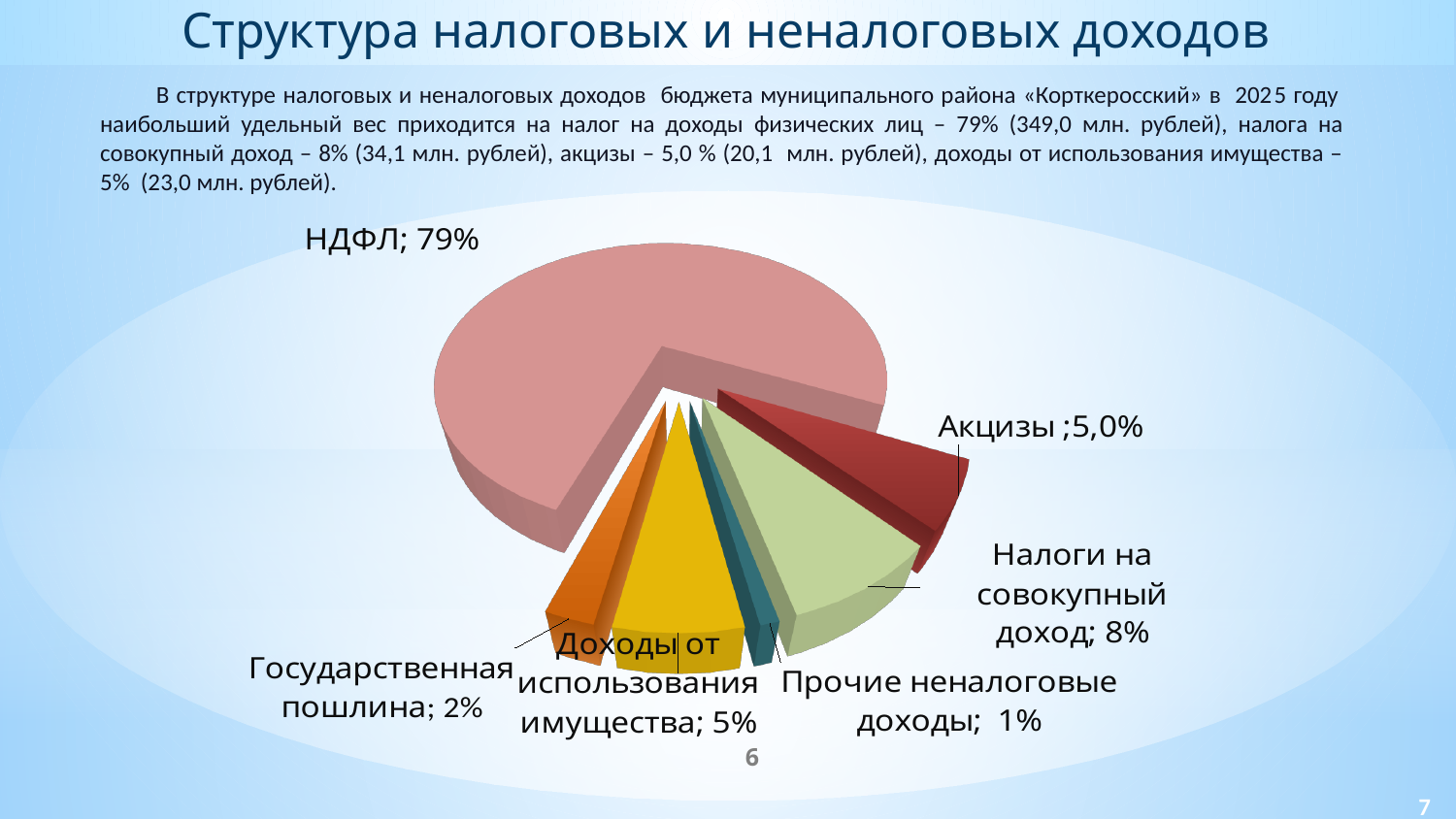
Which category has the largest slice of the pie? НДФЛ What is the value shown for Прочие неналоговые доходы? 1% What share of the pie does НДФЛ account for? 79% How many slices does the pie chart have? 6 What kind of chart is shown on the slide? Pie chart What is the value shown for Доходы от использования имущества? 5% What is the value shown for Государственная пошлина? 2% What is the value shown for Акцизы? 5,0% Which is larger, Налоги на совокупный доход or Государственная пошлина? Налоги на совокупный доход What is the value shown for Налоги на совокупный доход? 8% Which category has the smallest slice of the pie? Прочие неналоговые доходы By how many percentage points does НДФЛ exceed Налоги на совокупный доход? 71